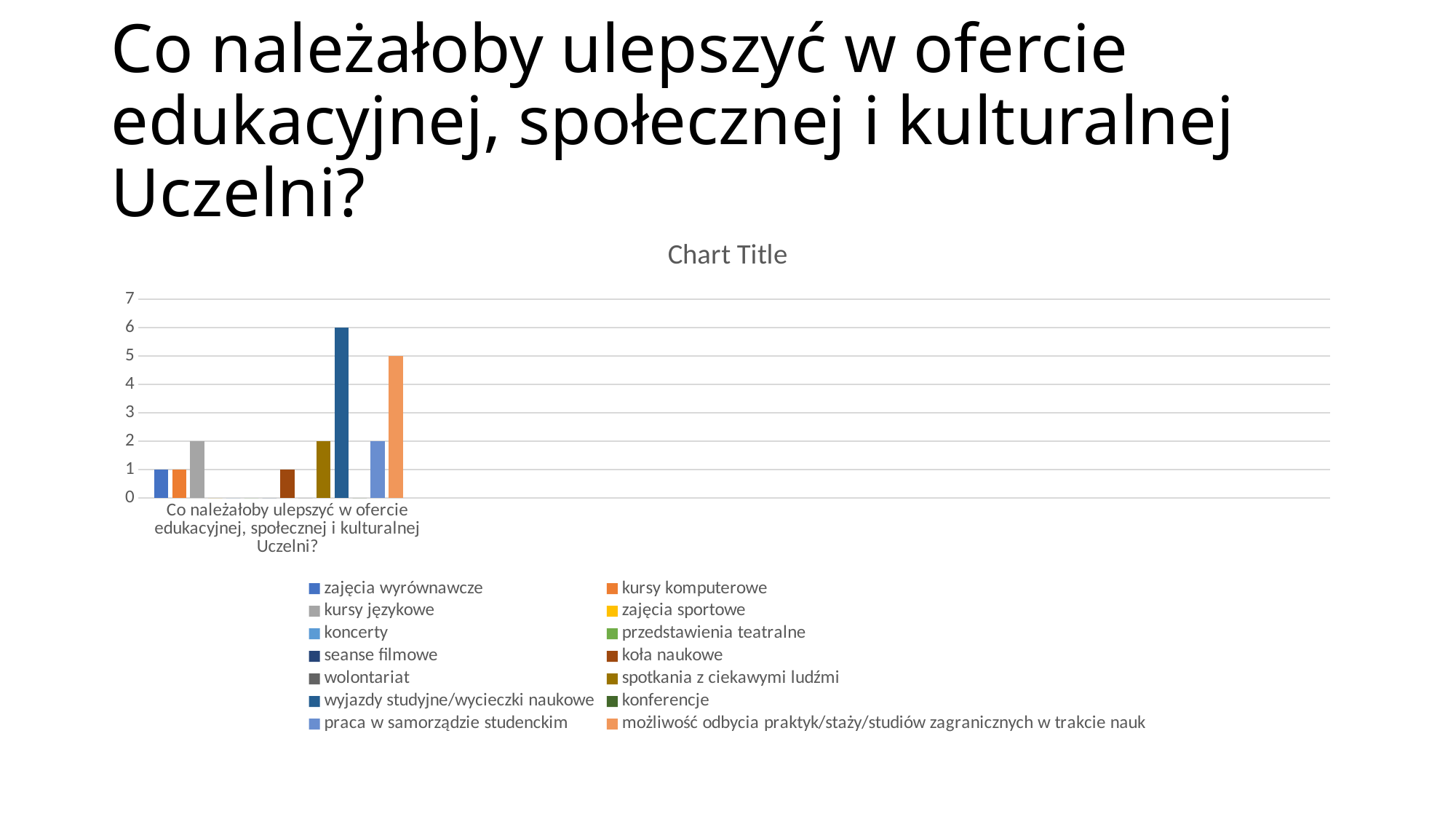
Which series has the highest value? wyjazdy studyjne/wycieczki naukowe How many series does the legend list? 14 What is the value for wyjazdy studyjne/wycieczki naukowe? 6 What is the value for kursy językowe? 2 What is the value for możliwość odbycia praktyk/staży/studiów zagranicznych w trakcie nauk? 5 What is the difference between the values for wyjazdy studyjne/wycieczki naukowe and możliwość odbycia praktyk/staży/studiów zagranicznych w trakcie nauk? 1 What is the value for spotkania z ciekawymi ludźmi? 2 Is the value for wyjazdy studyjne/wycieczki naukowe greater or less than 4? greater Which is larger, the value for praca w samorządzie studenckim or the value for zajęcia wyrównawcze? praca w samorządzie studenckim What is the value for koła naukowe? 1 What kind of chart is shown on the slide? bar chart What is the title shown above the chart? Chart Title